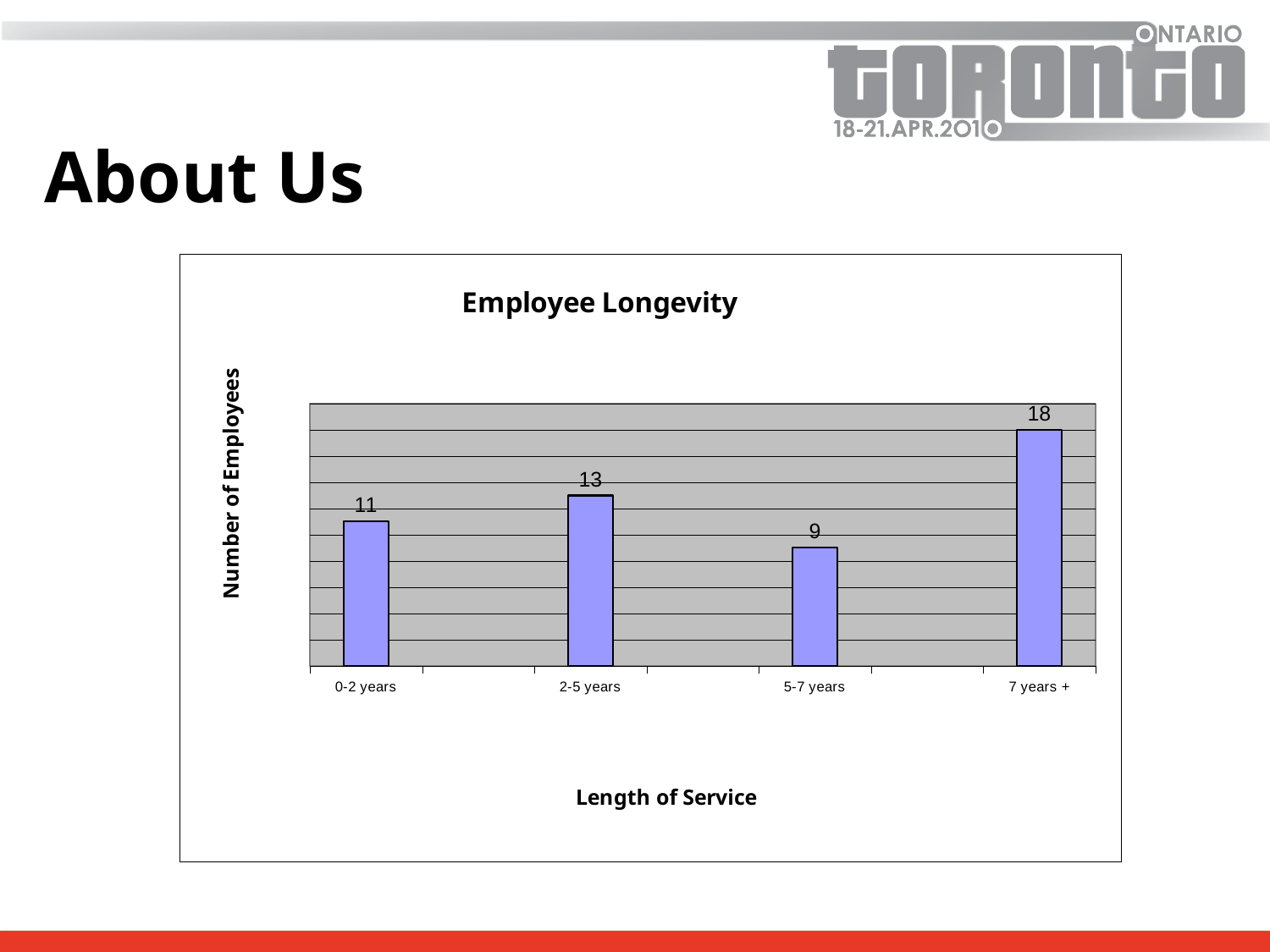
What is the difference in number of employees between the 2-5 years and 5-7 years categories? 4 What is the number of employees with 0-2 years of service? 11 How many length of service categories are shown in the chart? 4 What is the number of employees with 2-5 years of service? 13 Which has more employees: 0-2 years or 2-5 years? 2-5 years Which length of service category has the lowest number of employees? 5-7 years What is the title of the chart? Employee Longevity What type of chart is shown on the slide? Bar chart What is the number of employees with 7 years + of service? 18 What is the difference in number of employees between the 7 years + and 0-2 years categories? 7 Which length of service category has the highest number of employees? 7 years + What is the number of employees with 5-7 years of service? 9